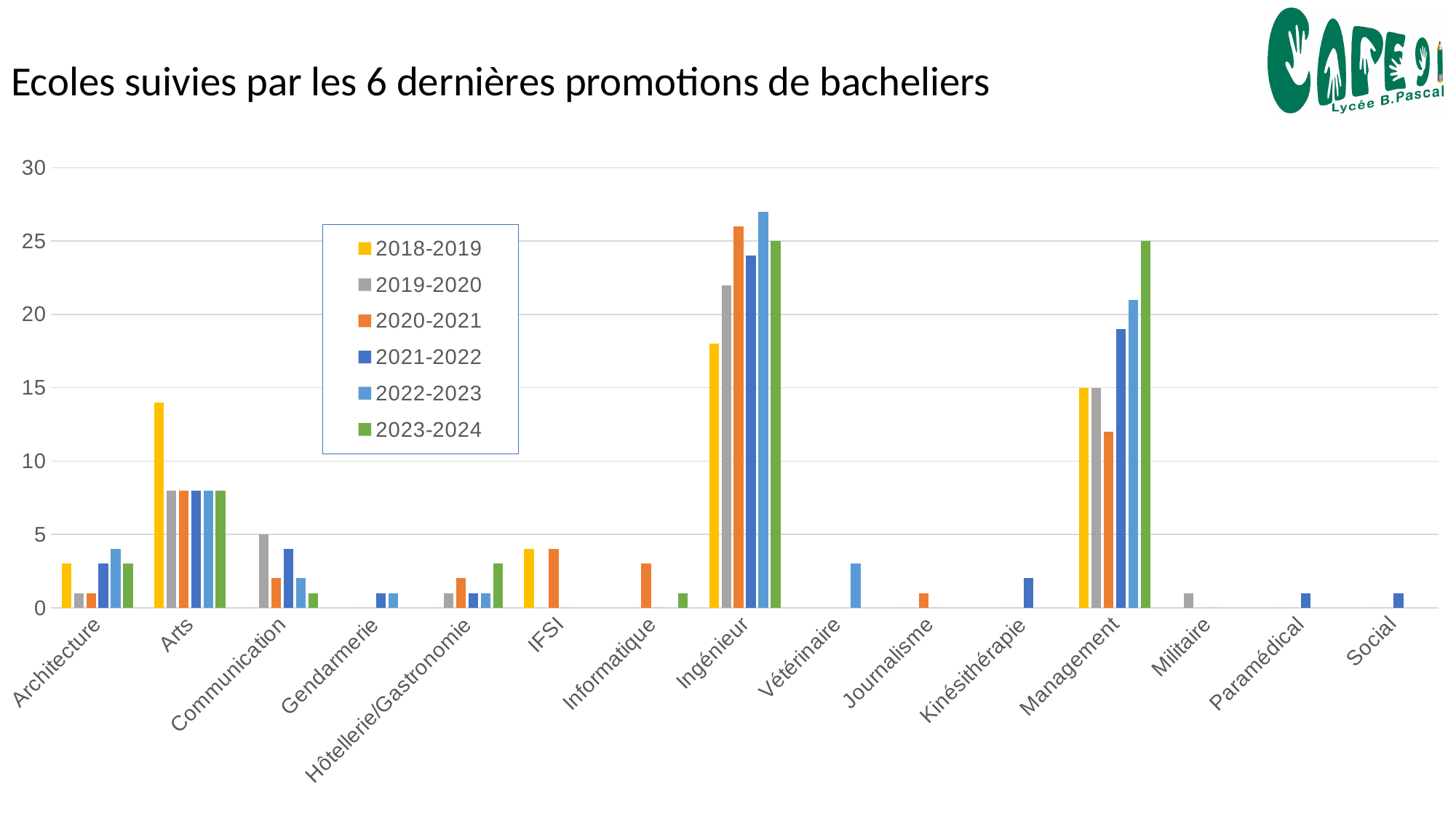
Which category has the tallest bars overall? Ingénieur How many school categories are shown on the x axis? 15 Which is larger for 2022-2023: Ingénieur or Management? Ingénieur Is the value for Management in 2020-2021 greater or less than 15? less What is the title of the chart? Ecoles suivies par les 6 dernières promotions de bacheliers Do the Management values rise or fall from 2020-2021 to 2023-2024? rise Is the value for Ingénieur in 2022-2023 greater or less than 25? greater Which is larger for Arts: 2018-2019 or 2019-2020? 2018-2019 What is the value for Ingénieur in 2023-2024? 25 Is the value for Arts in 2018-2019 greater or less than 10? greater How many series does the legend list? 6 What kind of chart is shown on the slide? bar chart